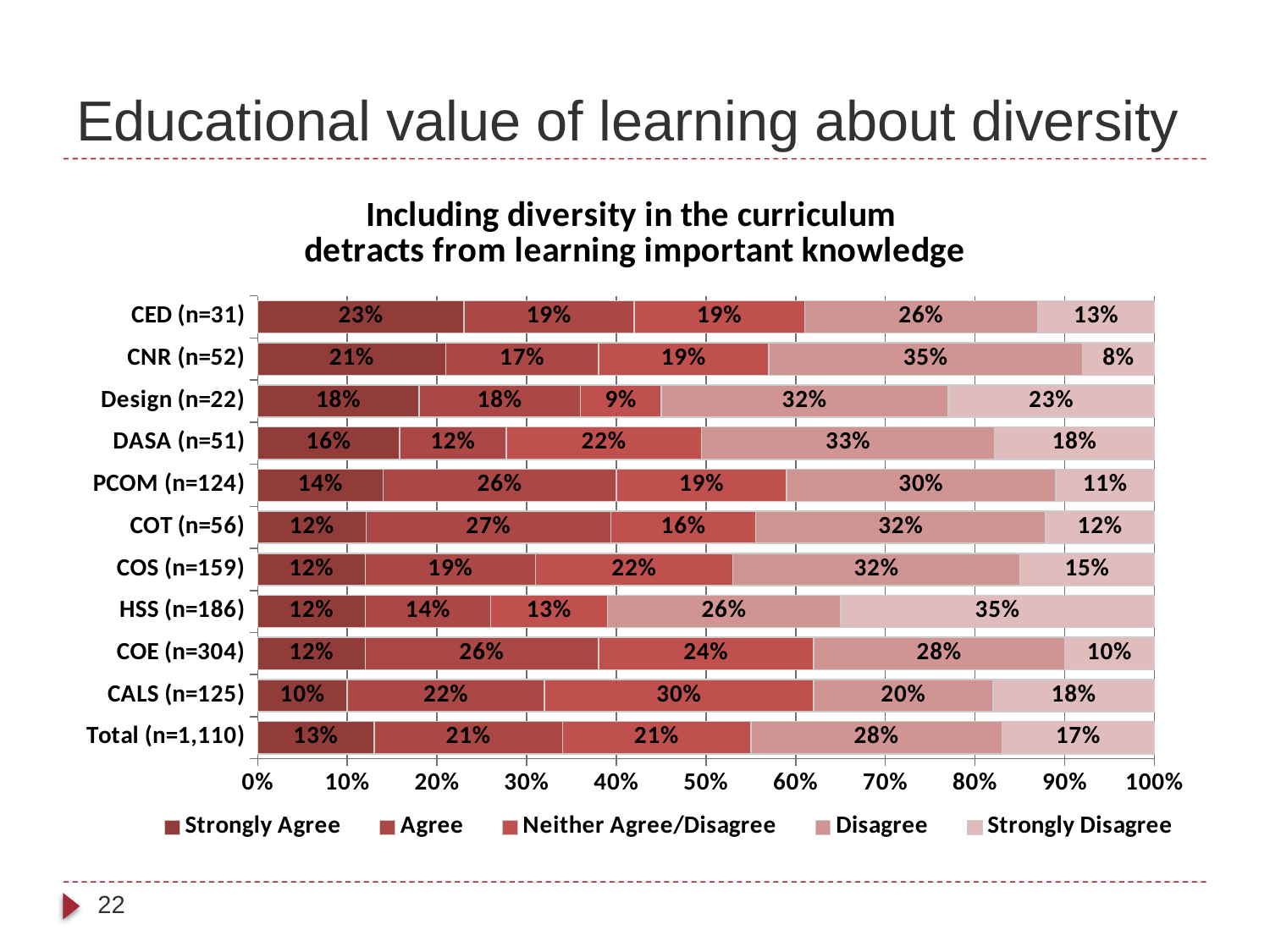
What type of chart is shown on the slide? Stacked bar chart What is the Neither Agree/Disagree value for CALS (n=125)? 30% Which group has the highest Disagree percentage? CNR (n=52) What percentage of CED (n=31) respondents Strongly Agree? 23% Which group has the highest Strongly Agree percentage? CED (n=31) Which is larger, the Agree value for COT (n=56) or the Agree value for DASA (n=51)? COT (n=56) How many response categories does the legend list? 5 What percentage of HSS (n=186) respondents Strongly Disagree? 35% Which group has the lowest Strongly Agree percentage? CALS (n=125) What is the difference between the Strongly Disagree values for HSS (n=186) and CNR (n=52)? 27% How many groups (bars) are shown in the chart? 11 What is the Disagree value for Total (n=1,110)? 28%